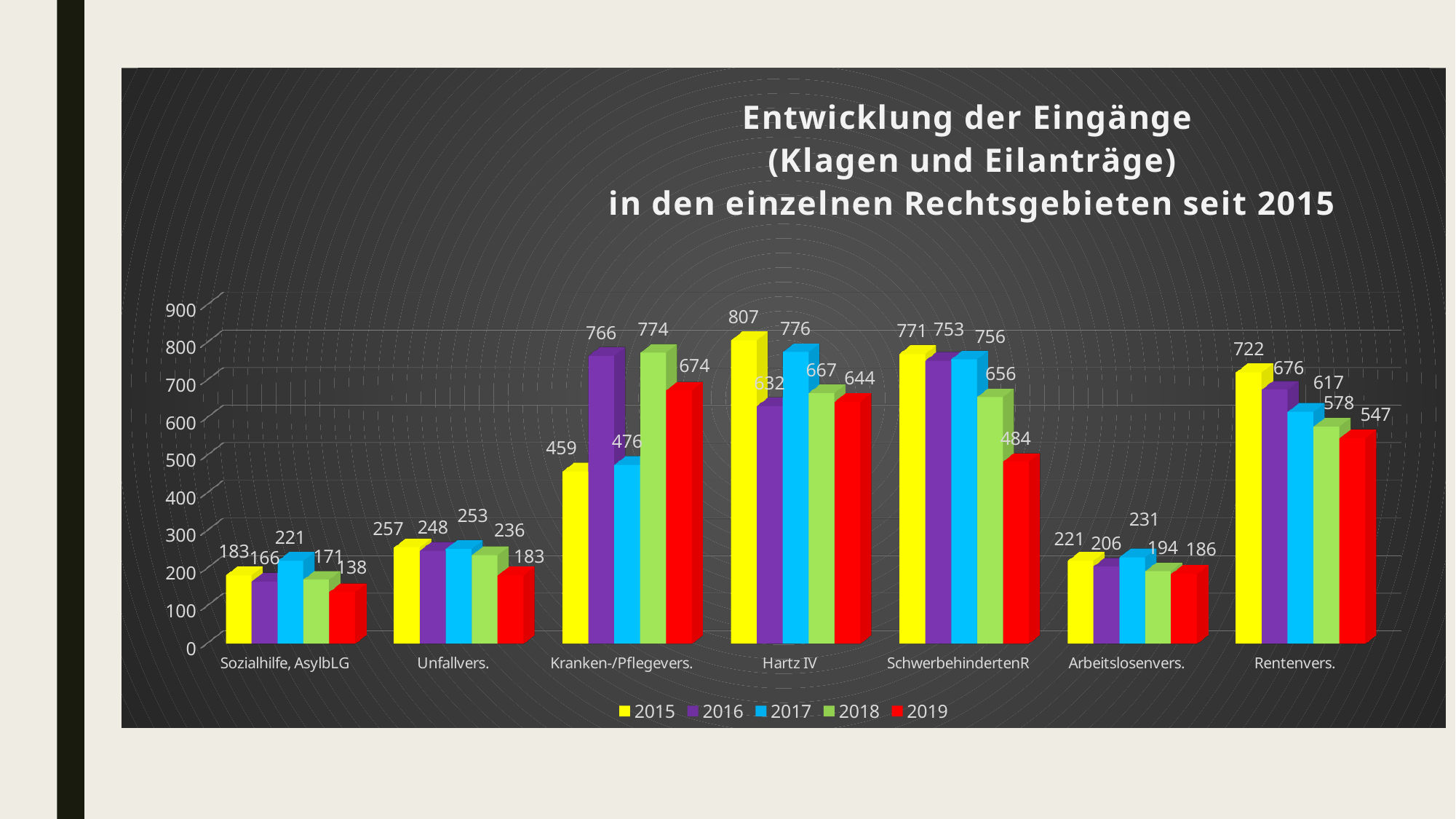
What kind of chart is shown on the slide? Bar chart What is the difference between the 2015 and 2019 values for Rentenvers.? 175 Which category has the lowest value in 2019? Sozialhilfe, AsylbLG How many categories (Rechtsgebiete) are shown on the x axis? 7 Which is larger for Kranken-/Pflegevers.: the 2016 value or the 2017 value? 2016 Which category has the highest value in 2015? Hartz IV What is the value for Rentenvers. in 2019? 547 What is the value for Hartz IV in 2015? 807 What is the value for Kranken-/Pflegevers. in 2018? 774 Do the values for Rentenvers. rise or fall from 2015 to 2019? Fall What is the title of the chart? Entwicklung der Eingänge (Klagen und Eilanträge) in den einzelnen Rechtsgebieten seit 2015 How many series does the legend list? 5